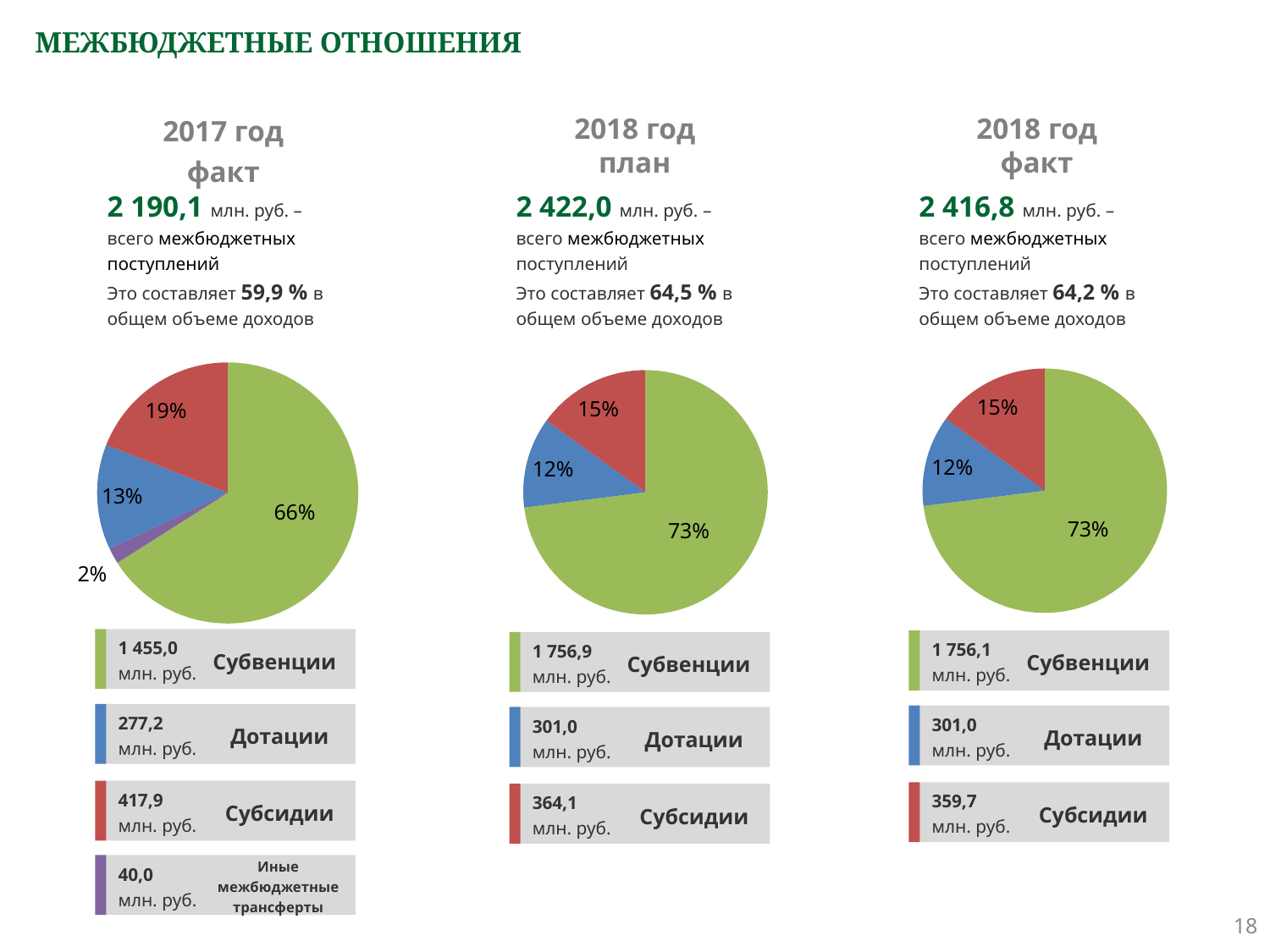
In the 2017 год факт pie chart, what share of the pie is Иные межбюджетные трансферты? 2% In the 2018 год план chart, what is the value shown for Субвенции? 1 756,9 млн. руб. What type of chart is used on this slide? Pie chart In the 2017 год факт chart, which category has the smallest slice? Иные межбюджетные трансферты In the 2018 год факт chart, which is larger, Дотации or Субсидии? Субсидии In the 2018 год план pie chart, what share of the pie is Дотации? 12% In the 2018 год факт chart, what is the value shown for Субсидии? 359,7 млн. руб. In the 2017 год факт pie chart, what share of the pie is Субвенции? 66% In the 2017 год факт chart, what is the value shown for Субсидии? 417,9 млн. руб. How many slices does the 2017 год факт pie chart have? 4 In the 2018 год план chart, which category has the largest slice? Субвенции How many slices does the 2018 год факт pie chart have? 3